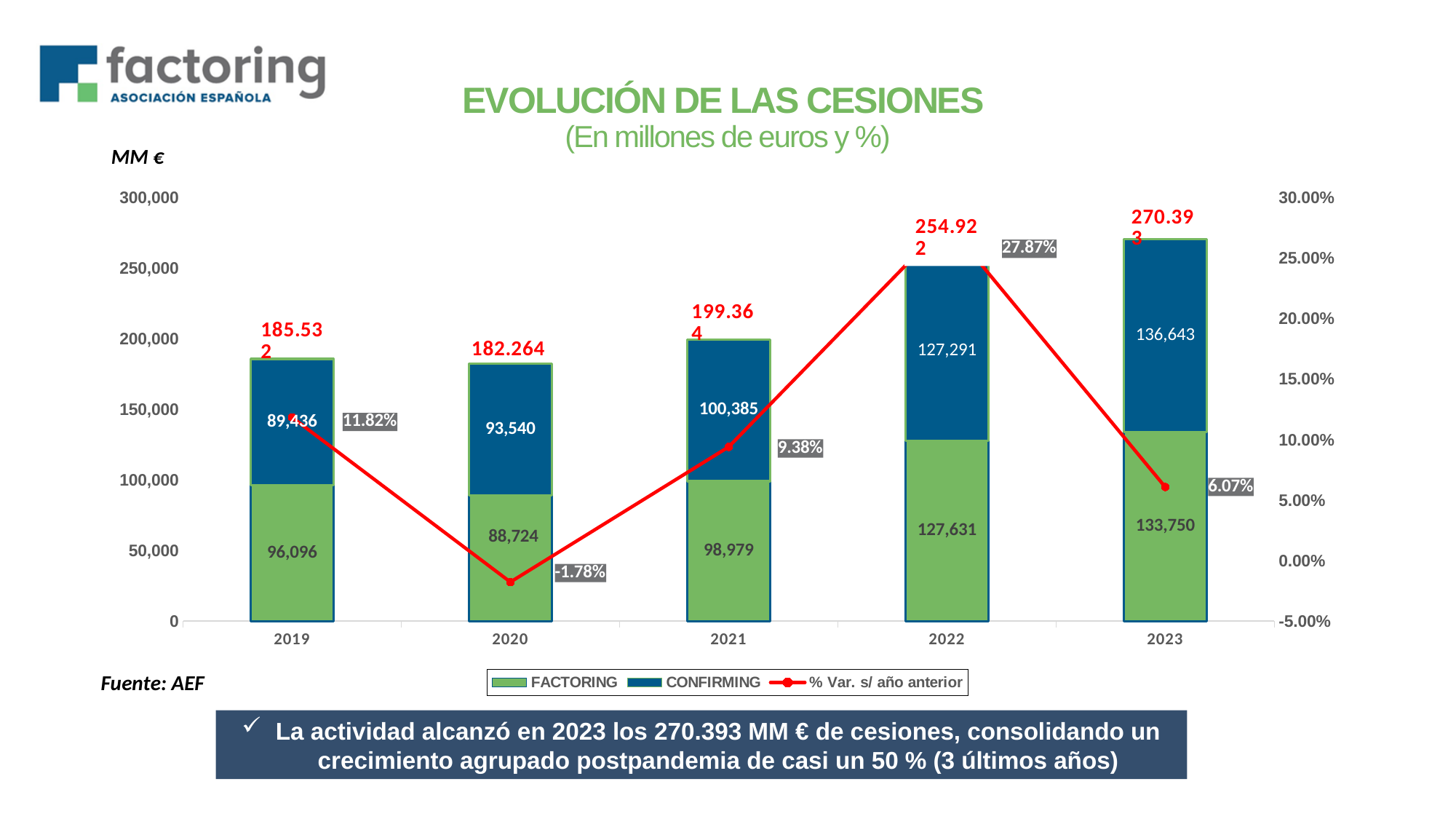
Does the FACTORING value rise or fall from 2021 to 2023? Rise What is the difference between the CONFIRMING values for 2022 and 2021? 26,906 What is the FACTORING value for 2021? 98,979 How many years are shown on the x axis? 5 What is the total of the stacked bar for 2020, as labelled on the chart? 182.264 What is the % Var. s/ año anterior value for 2022? 27.87% What is the CONFIRMING value for 2023? 136,643 In 2019, which is larger, the FACTORING value or the CONFIRMING value? FACTORING Which year has the highest FACTORING value? 2023 What kind of chart is shown on the slide? Stacked bar chart with a line Which year has the lowest % Var. s/ año anterior value? 2020 How many series does the legend list? 3